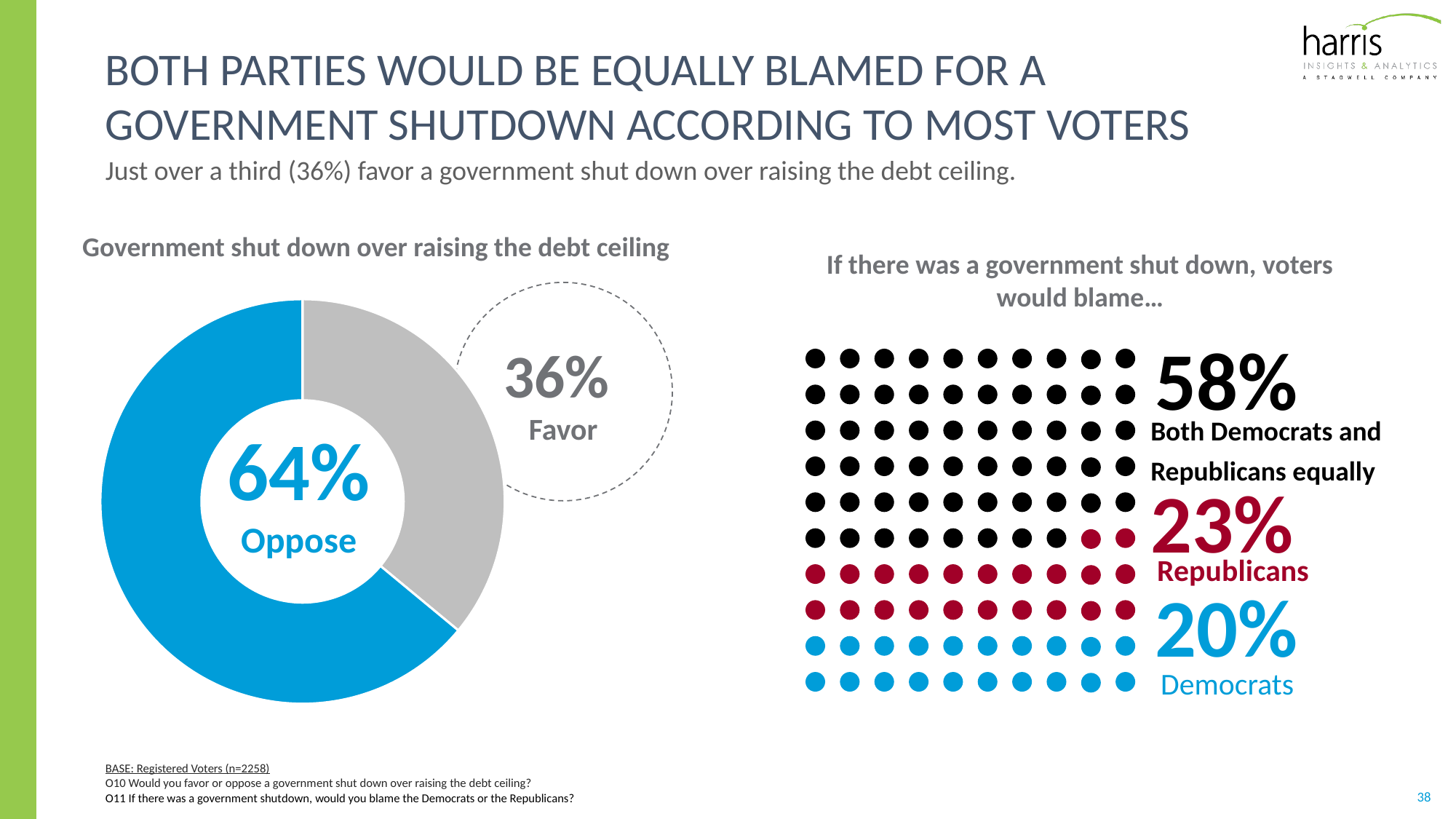
In the 'Government shut down over raising the debt ceiling' chart, what is the difference in percentage points between Oppose and Favor? 28 percentage points In the 'If there was a government shut down, voters would blame...' chart, what percentage would blame Republicans? 23% What kind of chart is the 'Government shut down over raising the debt ceiling' chart? Donut (pie) chart In the 'Government shut down over raising the debt ceiling' chart, what percentage of voters oppose a shutdown? 64% In the 'If there was a government shut down, voters would blame...' chart, what percentage would blame both Democrats and Republicans equally? 58% In the 'If there was a government shut down, voters would blame...' chart, which response has the lowest percentage? Democrats In the 'If there was a government shut down, voters would blame...' chart, what percentage would blame Democrats? 20% In the 'Government shut down over raising the debt ceiling' chart, what percentage of voters favor a shutdown? 36% In the 'Government shut down over raising the debt ceiling' chart, which response has the larger share, Oppose or Favor? Oppose In the 'Government shut down over raising the debt ceiling' chart, how many categories are shown? 2 In the 'If there was a government shut down, voters would blame...' chart, what is the difference in percentage points between Republicans and Democrats? 3 percentage points In the 'If there was a government shut down, voters would blame...' chart, what colour are the dots representing Democrats? Blue